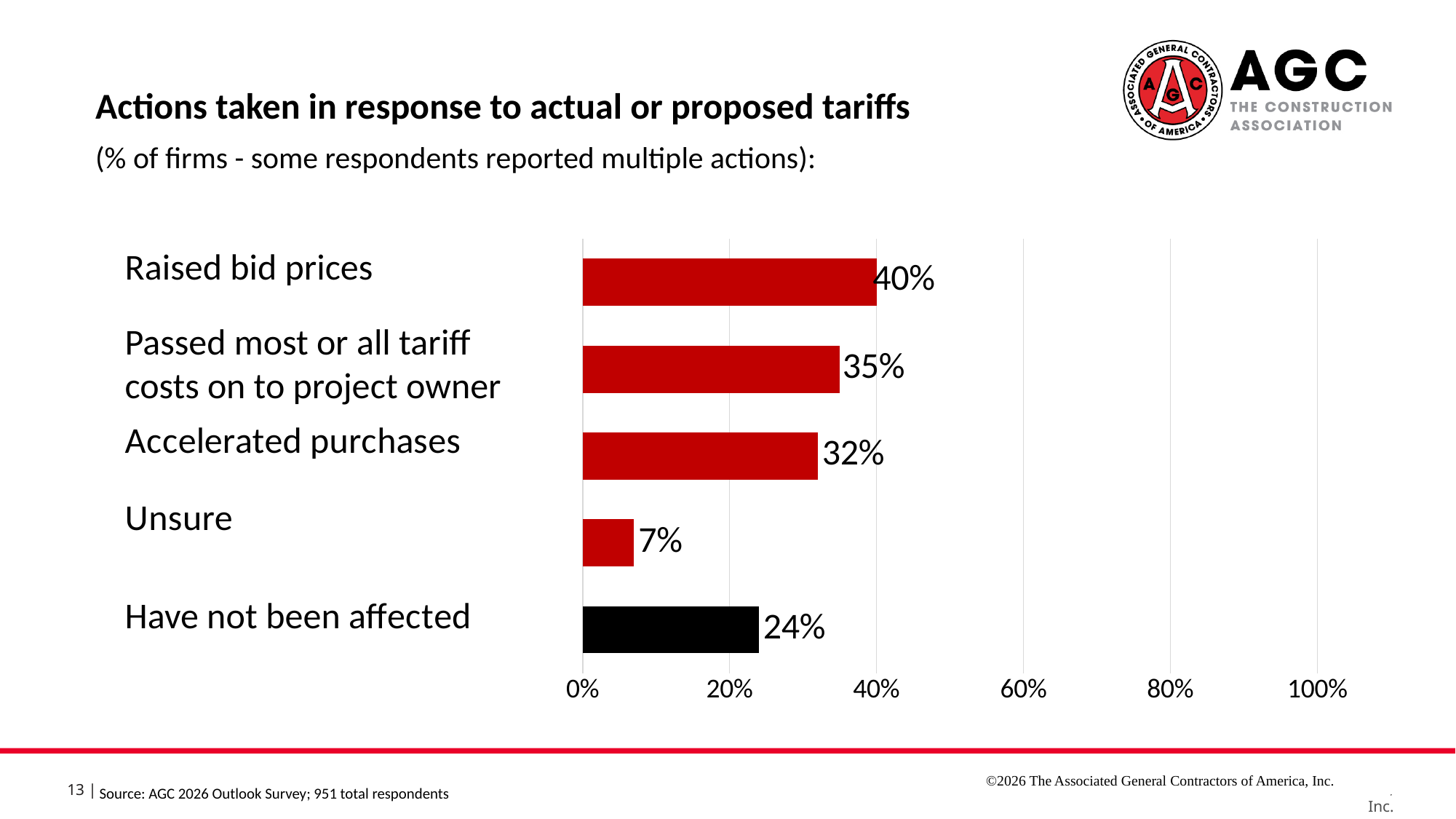
Which action has the highest percentage of firms? Raised bid prices What percentage of firms passed most or all tariff costs on to the project owner? 35% Which bar is coloured black rather than red? Have not been affected What percentage of firms accelerated purchases? 32% What percentage of firms raised bid prices in response to tariffs? 40% What kind of chart is shown on the slide? Bar chart Which category has the lowest percentage of firms? Unsure What percentage of firms reported they have not been affected? 24% What is the difference in percentage points between 'Raised bid prices' and 'Accelerated purchases'? 8 Which is larger: the percentage for 'Passed most or all tariff costs on to project owner' or for 'Have not been affected'? Passed most or all tariff costs on to project owner Is the value for 'Unsure' greater or less than 20%? less How many categories are shown in the chart? 5